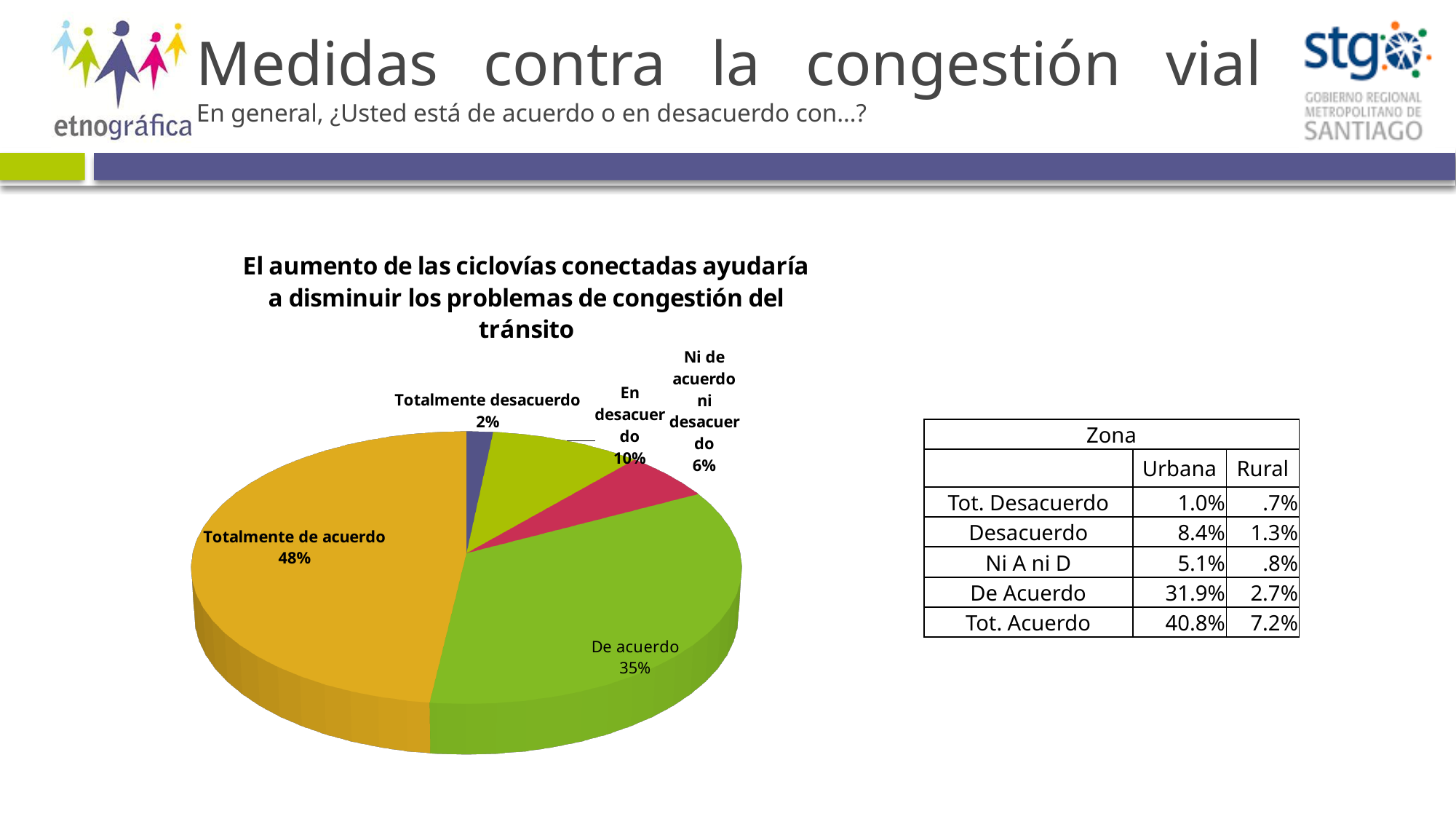
What is the value shown for 'En desacuerdo' in the pie chart? 10% Which is larger in the pie chart, 'En desacuerdo' or 'Ni de acuerdo ni desacuerdo'? En desacuerdo Which category has the smallest slice in the pie chart? Totalmente desacuerdo Which category has the largest slice in the pie chart? Totalmente de acuerdo What is the value shown for 'De acuerdo' in the pie chart? 35% What is the title of the pie chart? El aumento de las ciclovías conectadas ayudaría a disminuir los problemas de congestión del tránsito What is the difference in percentage points between 'Totalmente de acuerdo' and 'De acuerdo'? 13 What is the value shown for 'Totalmente desacuerdo' in the pie chart? 2% What is the value shown for 'Ni de acuerdo ni desacuerdo' in the pie chart? 6% How many categories are shown in the pie chart? 5 What share of the pie does the 'Totalmente de acuerdo' slice represent? 48% What kind of chart is shown on the slide? Pie chart